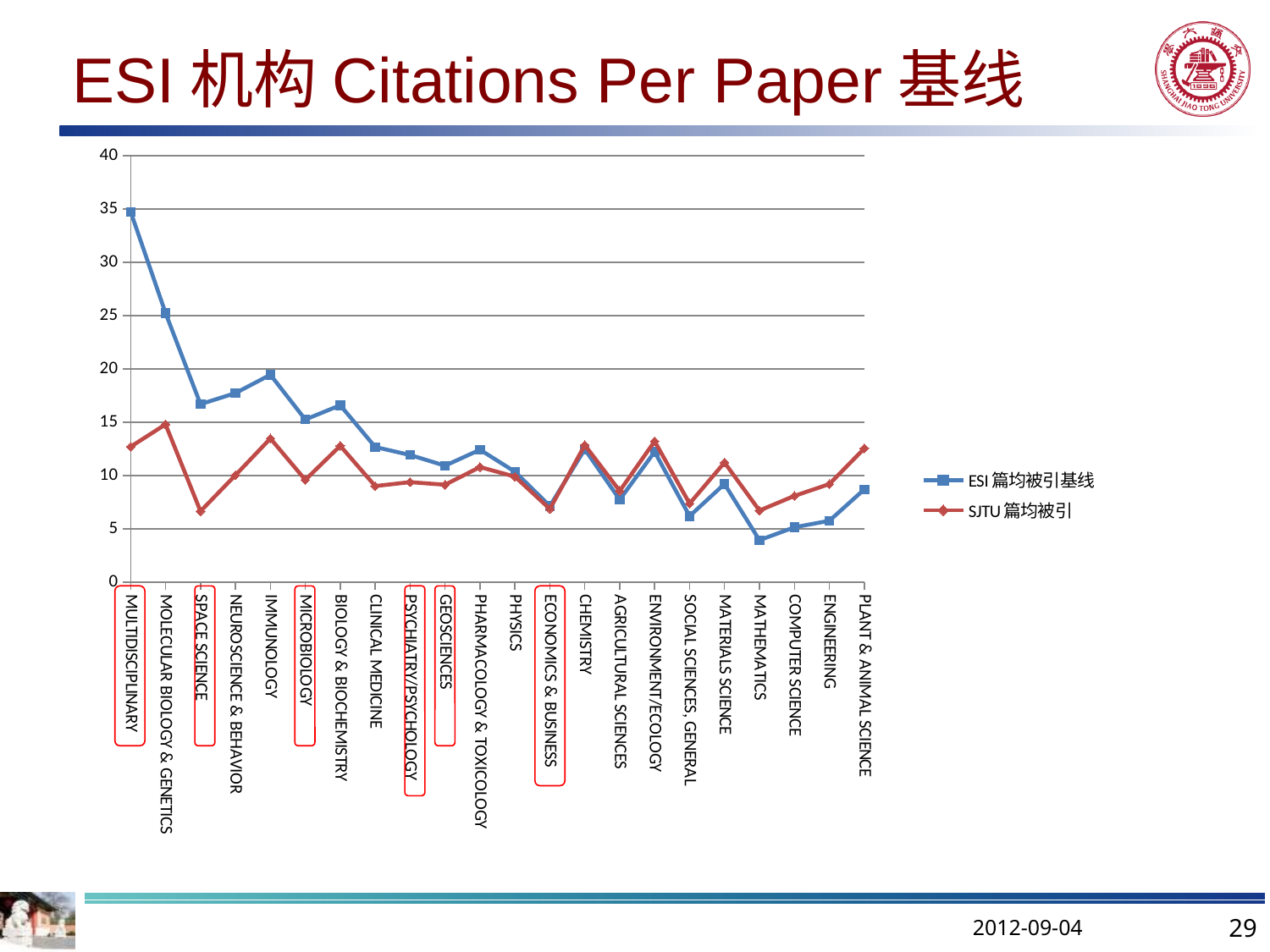
Does the ESI 篇均被引基线 series generally rise or fall from left to right along the x axis? fall Is the ESI 篇均被引基线 value for MATHEMATICS greater or less than 5? less Which category has the highest value for the ESI 篇均被引基线 series? MULTIDISCIPLINARY How many series does the legend list? 2 For ENGINEERING, which series has the larger value, ESI 篇均被引基线 or SJTU 篇均被引? SJTU 篇均被引 Is the SJTU 篇均被引 value for SPACE SCIENCE greater or less than 10? less Is the ESI 篇均被引基线 value for MULTIDISCIPLINARY greater or less than 30? greater For MULTIDISCIPLINARY, which series has the larger value, ESI 篇均被引基线 or SJTU 篇均被引? ESI 篇均被引基线 How many categories are plotted along the x axis? 22 Which category has the lowest value for the ESI 篇均被引基线 series? MATHEMATICS What kind of chart is shown on the slide? Line chart